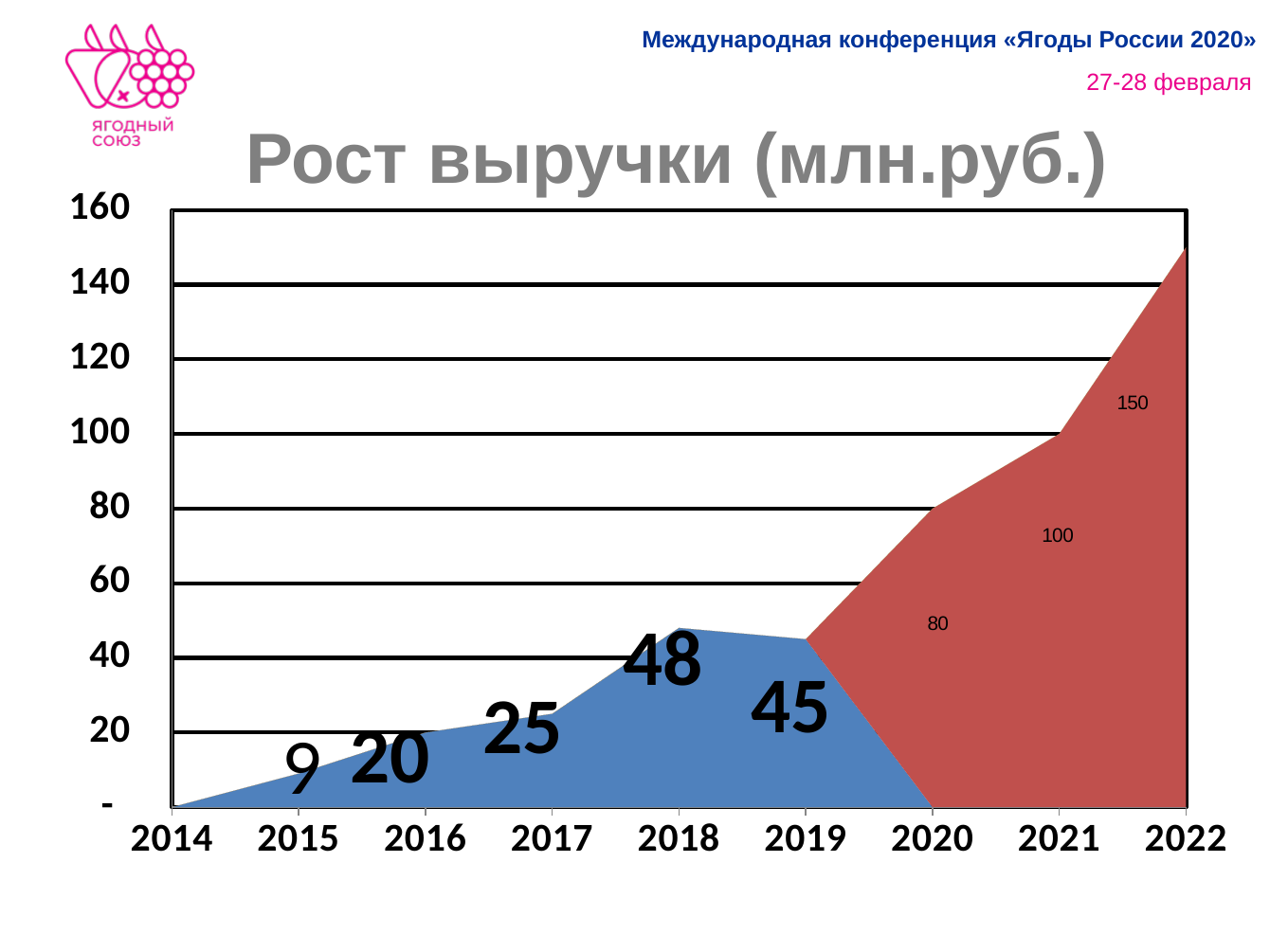
What is the difference between the values for 2018 and 2019? 3 What is the value for 2015? 9 What kind of chart is shown on the slide? area chart How many years are shown on the x axis? 9 What is the title of the chart? Рост выручки (млн.руб.) What is the value for 2021? 100 Do the values generally rise or fall from 2019 to 2022? rise What colour is the area for the years 2020 to 2022? red What is the difference between the values for 2022 and 2021? 50 Which is larger, the value for 2017 or the value for 2016? 2017 Which year has the highest value? 2022 What is the value for 2018? 48